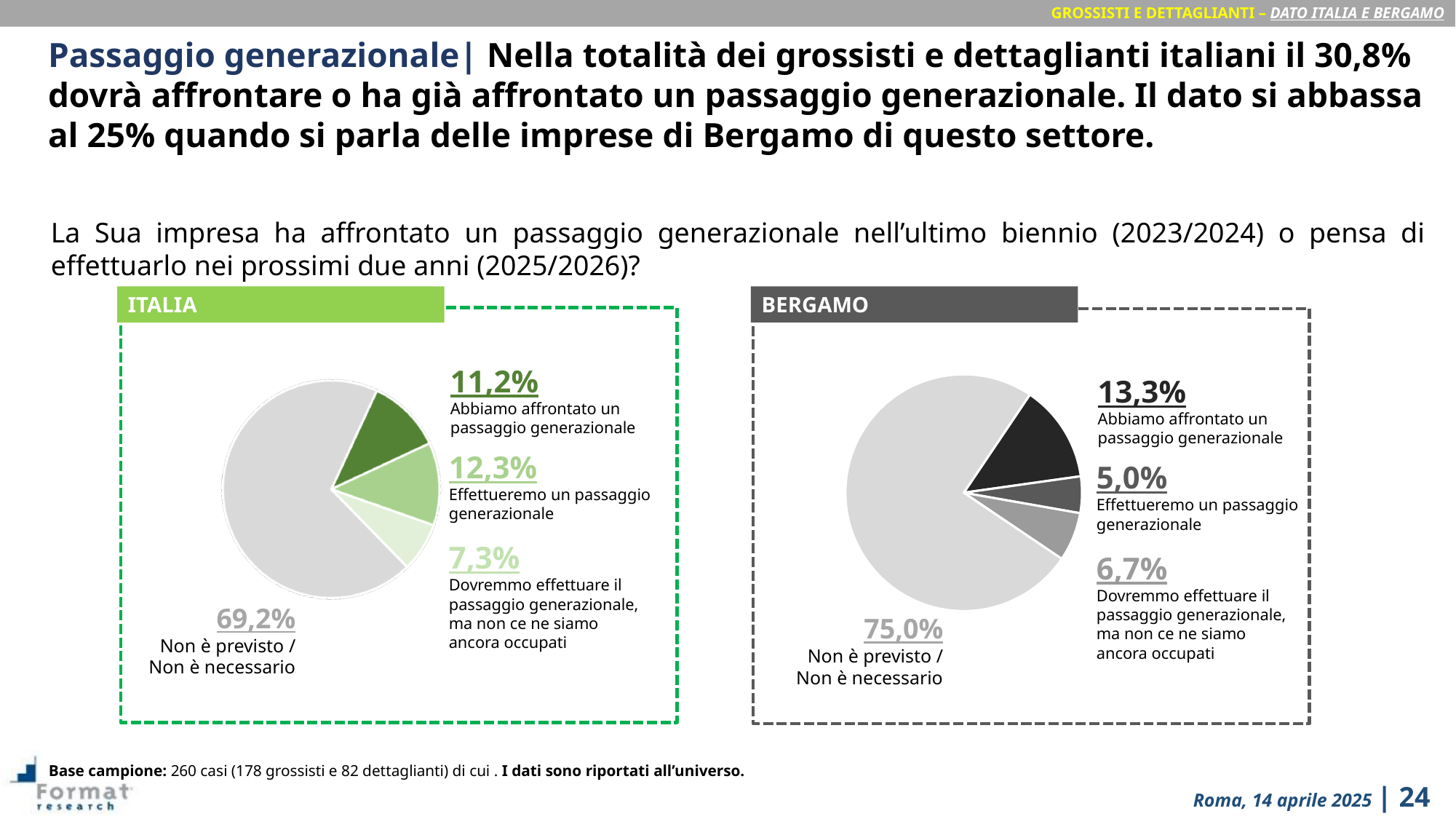
In the ITALIA chart, what share of respondents answered "Abbiamo affrontato un passaggio generazionale"? 11,2% In the BERGAMO chart, which category has the smallest slice? Effettueremo un passaggio generazionale In the BERGAMO chart, what share of respondents answered "Effettueremo un passaggio generazionale"? 5,0% In the ITALIA chart, what is the value for "Non è previsto / Non è necessario"? 69,2% Which chart shows a larger value for "Non è previsto / Non è necessario", ITALIA or BERGAMO? BERGAMO In the BERGAMO chart, what is the value for "Dovremmo effettuare il passaggio generazionale, ma non ce ne siamo ancora occupati"? 6,7% In the BERGAMO chart, what is the difference in percentage points between "Non è previsto / Non è necessario" and "Abbiamo affrontato un passaggio generazionale"? 61,7 percentage points What type of chart is used for the BERGAMO data? Pie chart How many categories does the ITALIA pie chart show? 4 In the ITALIA chart, which category has the smallest slice? Dovremmo effettuare il passaggio generazionale, ma non ce ne siamo ancora occupati In the ITALIA chart, what is the difference in percentage points between "Effettueremo un passaggio generazionale" and "Dovremmo effettuare il passaggio generazionale, ma non ce ne siamo ancora occupati"? 5,0 percentage points In the BERGAMO chart, which category has the largest slice? Non è previsto / Non è necessario